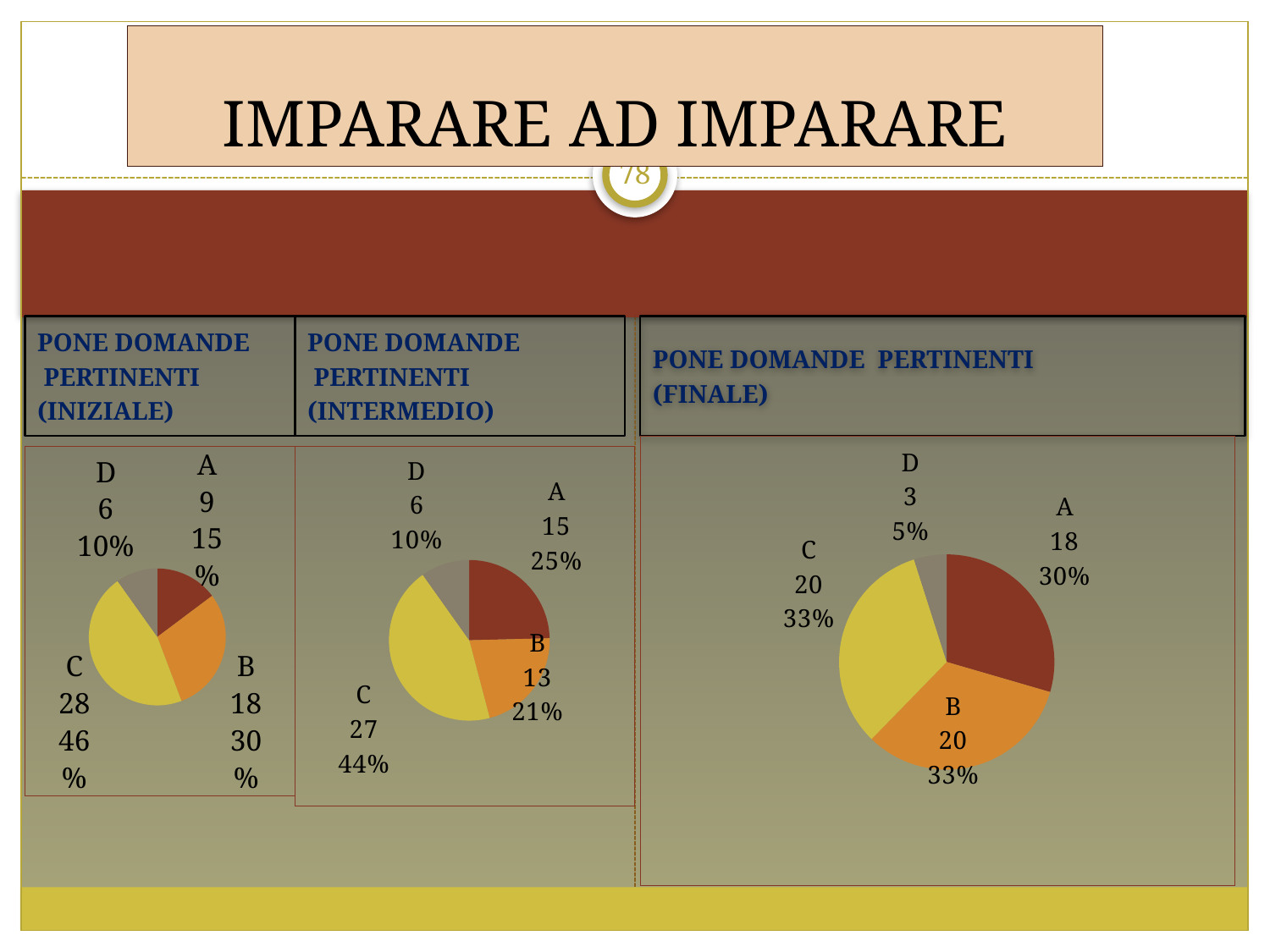
In the PONE DOMANDE PERTINENTI (INTERMEDIO) pie chart, which category has the smallest slice? D In the PONE DOMANDE PERTINENTI (INIZIALE) pie chart, what is the count for category C? 28 In the PONE DOMANDE PERTINENTI (FINALE) pie chart, what percentage share does category A have? 30% How many categories does the PONE DOMANDE PERTINENTI (FINALE) pie chart show? 4 What type of chart is used for PONE DOMANDE PERTINENTI (INIZIALE)? Pie chart In the PONE DOMANDE PERTINENTI (INIZIALE) pie chart, which category has the largest slice? C In the PONE DOMANDE PERTINENTI (FINALE) pie chart, what is the count for category D? 3 In the PONE DOMANDE PERTINENTI (INTERMEDIO) pie chart, what is the count for category A? 15 In the PONE DOMANDE PERTINENTI (FINALE) pie chart, which is larger, the count for A or the count for D? A In the PONE DOMANDE PERTINENTI (INIZIALE) pie chart, what percentage share does category B have? 30% In the PONE DOMANDE PERTINENTI (INTERMEDIO) pie chart, what is the difference between the counts for C and A? 12 In the PONE DOMANDE PERTINENTI (INTERMEDIO) pie chart, what percentage share does category C have? 44%